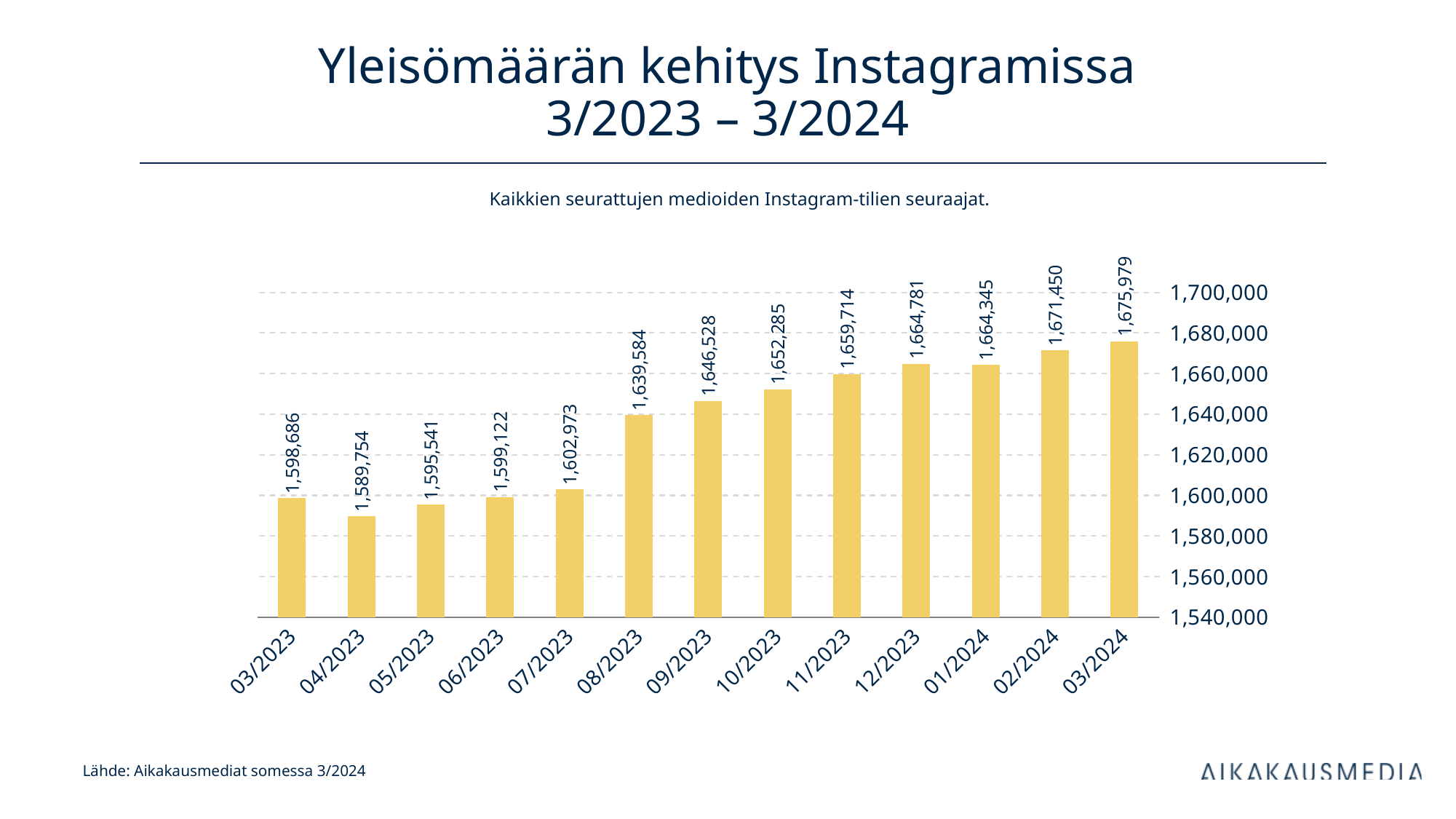
Which is larger, the value for 12/2023 or the value for 01/2024? 12/2023 What kind of chart is shown on the slide? bar chart Which month has the highest value? 03/2024 Which month has the lowest value? 04/2023 What is the value for 03/2023? 1,598,686 Do the values generally rise or fall from 03/2023 to 03/2024? rise What is the difference between the values for 08/2023 and 07/2023? 36,611 What is the difference between the values for 03/2024 and 03/2023? 77,293 Is the value for 10/2023 greater or less than 1,640,000? greater What is the value for 08/2023? 1,639,584 How many months are shown on the x axis? 13 What is the value for 01/2024? 1,664,345